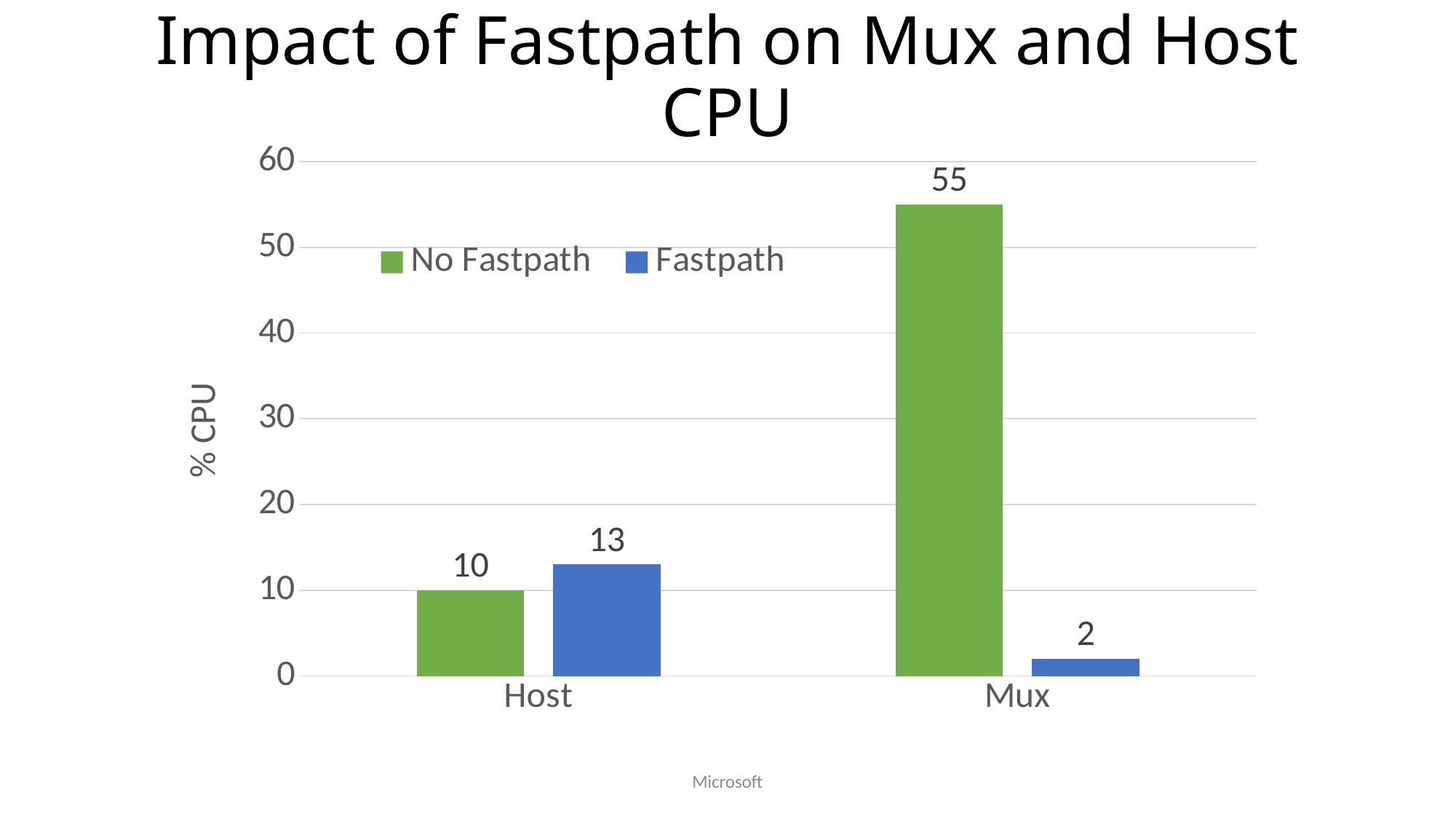
What is the Fastpath value for Host? 13 What kind of chart is shown on the slide? Bar chart How many series does the legend list? 2 Which category has the lowest Fastpath value? Mux Which category has the highest No Fastpath value? Mux For Host, which is larger: the No Fastpath value or the Fastpath value? Fastpath What is the No Fastpath value for Host? 10 What is the No Fastpath value for Mux? 55 What is the Fastpath value for Mux? 2 What is the label of the y axis? % CPU What is the difference between the No Fastpath and Fastpath values for Mux? 53 How many categories are shown on the x axis? 2